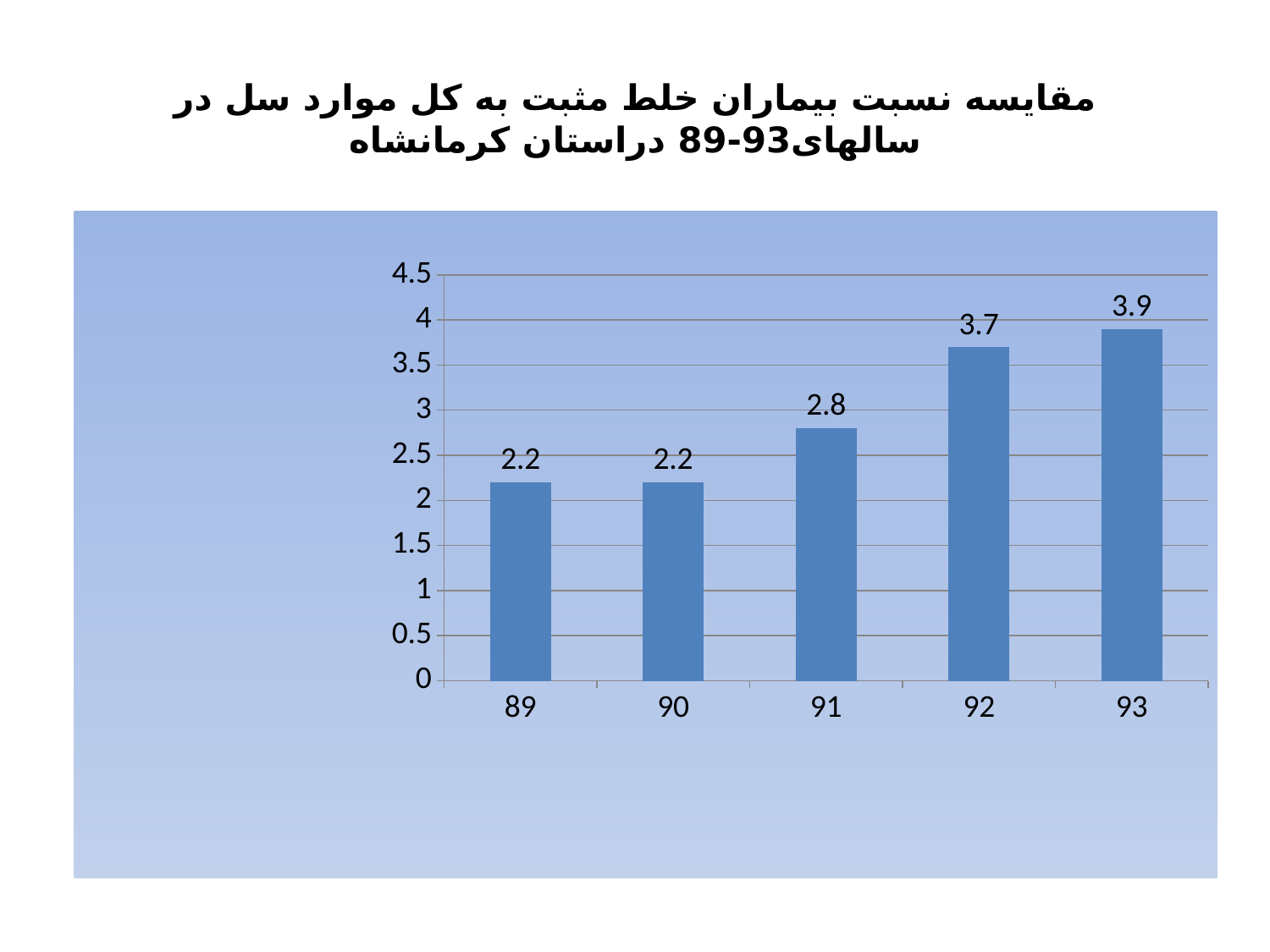
What kind of chart is shown on the slide? bar chart How many years are shown on the x axis? 5 What is the difference between the values for 93 and 92? 0.2 Which is larger, the value for 91 or the value for 92? 92 What is the value for year 93? 3.9 Is the value for 92 greater or less than 3.5? greater Which year has the highest value? 93 What is the value for year 89? 2.2 What is the maximum value shown on the y axis? 4.5 Do the values generally rise or fall from 89 to 93? rise What is the value for year 91? 2.8 What is the difference between the values for 92 and 91? 0.9